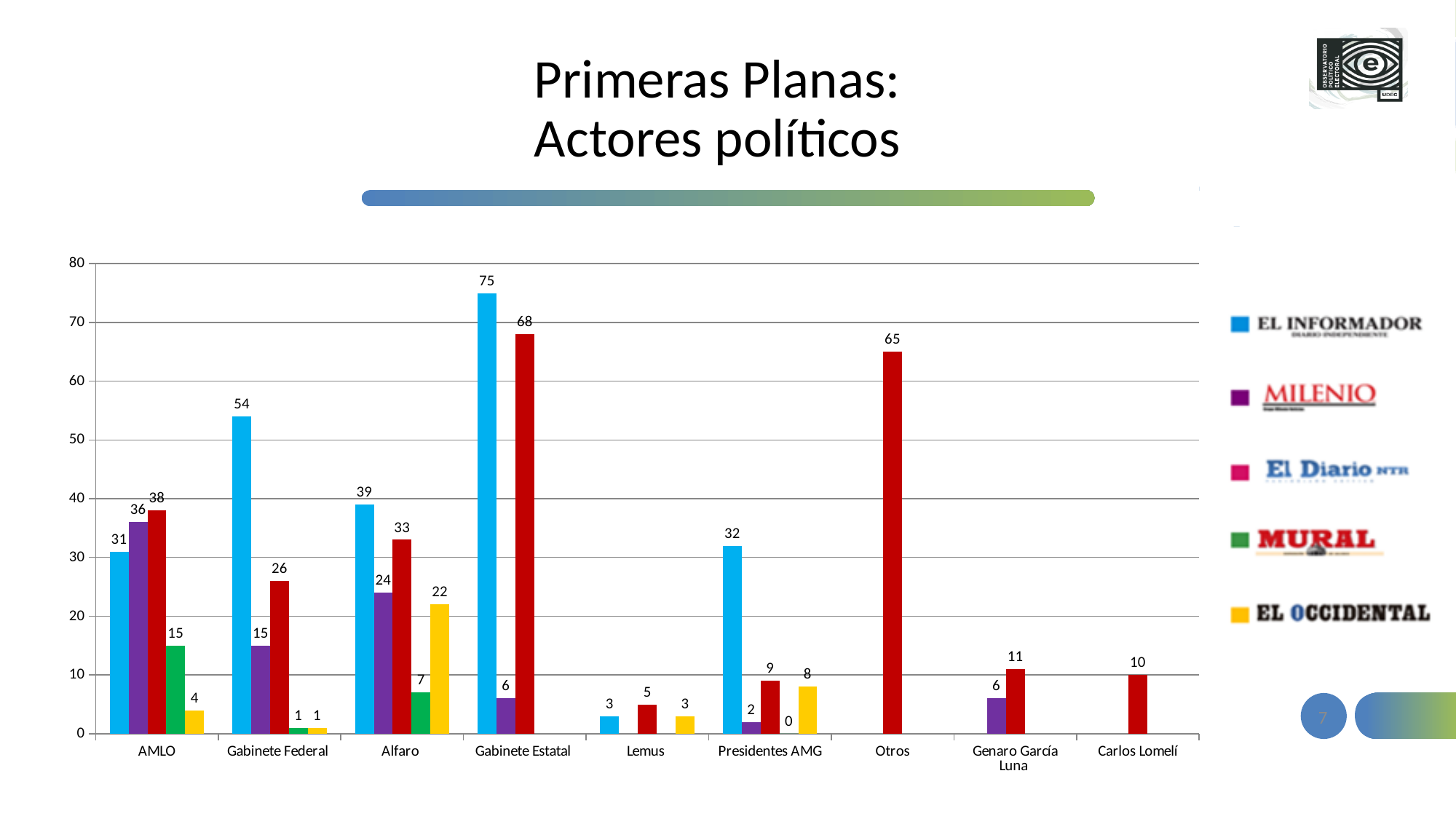
Which category has the lowest El Diario NTR value? Lemus What is the value for Mural in the Presidentes AMG category? 0 Which category has the highest El Informador value? Gabinete Estatal How many categories are shown along the x axis of the chart? 9 In the AMLO category, which is larger: the Milenio value or the El Diario NTR value? El Diario NTR How many series (newspapers) does the legend list? 5 What is the value for El Diario NTR in the Otros category? 65 What is the value for El Informador in the Gabinete Estatal category? 75 What is the difference between the El Informador and El Diario NTR values for Gabinete Federal? 28 What is the title of the slide containing the chart? Primeras Planas: Actores políticos What type of chart is shown on the slide? bar chart What is the value for El Occidental in the Alfaro category? 22